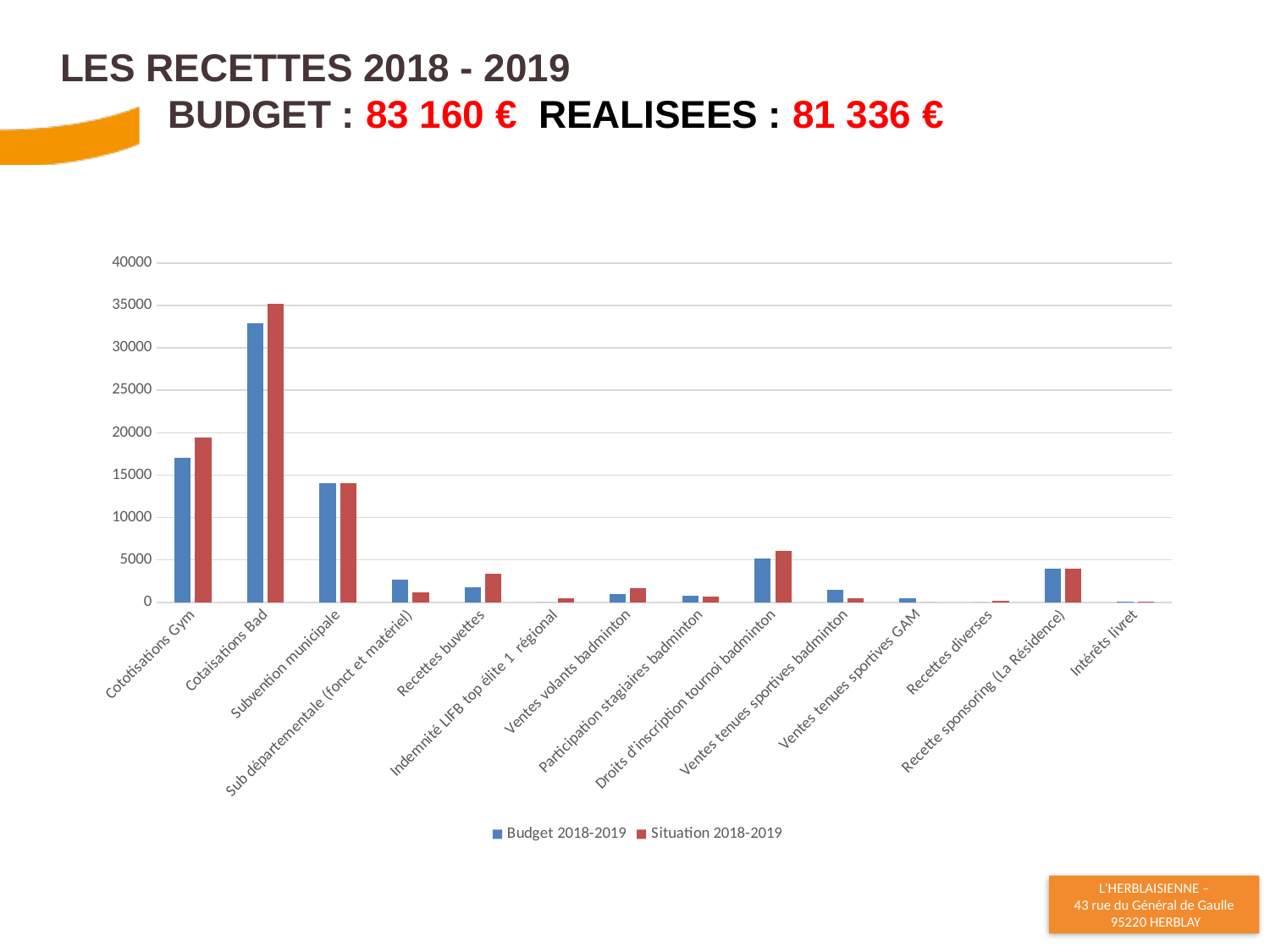
How many series does the legend list? 2 For Cotisations Gym, which is larger: Budget 2018-2019 or Situation 2018-2019? Situation 2018-2019 Which category has the highest value for Budget 2018-2019? Cotaisations Bad What kind of chart is shown on the slide? Bar chart Is the Situation 2018-2019 value for Recette sponsoring (La Résidence) greater or less than 5000? less Is the Situation 2018-2019 value for Droits d'inscription tournoi badminton greater or less than 5000? greater How many categories are shown on the x axis of the chart? 14 Is the Budget 2018-2019 value for Cotisations Bad greater or less than 30000? greater What are the two series names listed in the legend? Budget 2018-2019 and Situation 2018-2019 For Sub départementale (fonct et matériel), which is larger: Budget 2018-2019 or Situation 2018-2019? Budget 2018-2019 Which category has the highest value for Situation 2018-2019? Cotaisations Bad